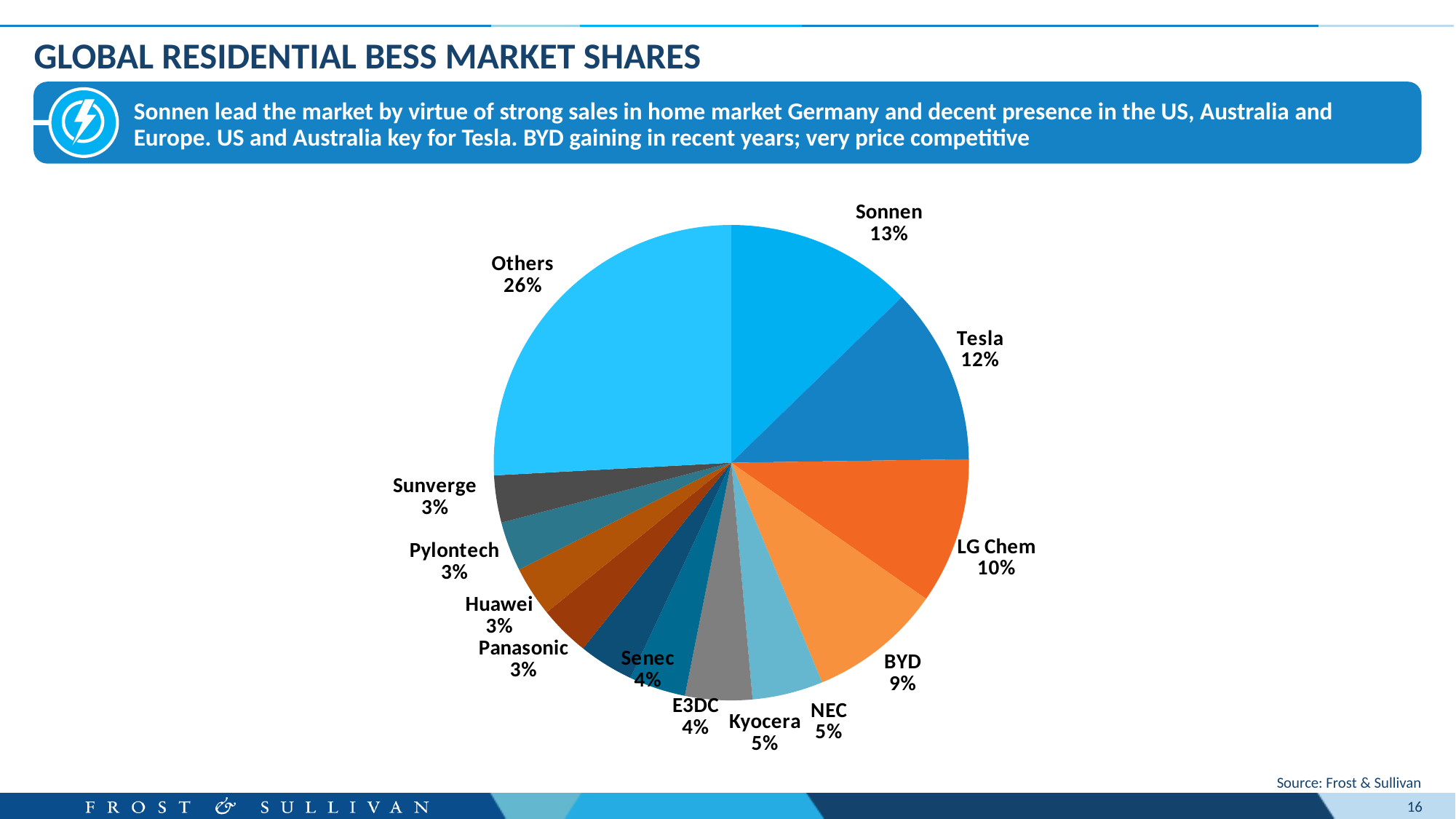
What is the title of the slide containing the chart? Global Residential BESS Market Shares What is the market share shown for BYD? 9% What share of the global residential BESS market does Sonnen hold? 13% What is the market share shown for Tesla? 12% What is the combined market share of Kyocera and NEC? 10% Which slice of the pie is the largest overall? Others What is the market share shown for LG Chem? 10% Which has a larger market share, LG Chem or BYD? LG Chem How many slices does the pie chart have? 13 What kind of chart is shown on the slide? Pie chart Which named company (excluding Others) has the largest slice of the pie? Sonnen What is the difference in market share between Sonnen and Tesla? 1%